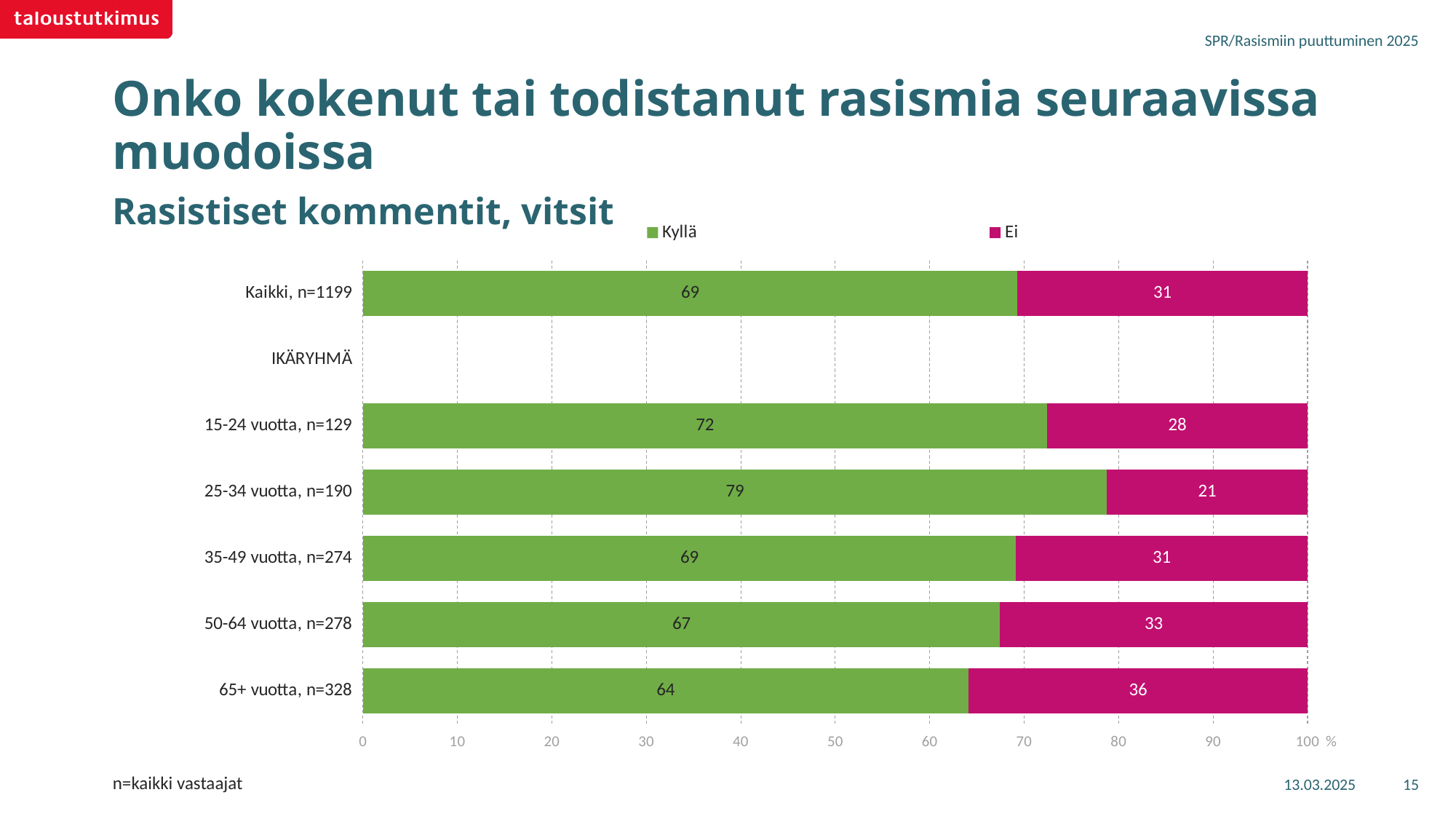
What is the total of the stacked bar for 50-64 vuotta, n=278? 100 What colour represents the Ei series? Magenta/pink Is the Kyllä value for 35-49 vuotta, n=274 greater or less than 60? greater How many series does the legend list? 2 What is the Ei value for 65+ vuotta, n=328? 36 What is the Kyllä value for 25-34 vuotta, n=190? 79 What is the Kyllä value for Kaikki, n=1199? 69 Which is larger, the Ei value for 50-64 vuotta or the Ei value for 15-24 vuotta? 50-64 vuotta Which age group has the lowest Kyllä value? 65+ vuotta, n=328 What kind of chart is shown on the slide? Stacked bar chart Which age group has the highest Kyllä value? 25-34 vuotta, n=190 What is the difference between the Kyllä values for 25-34 vuotta and 65+ vuotta? 15